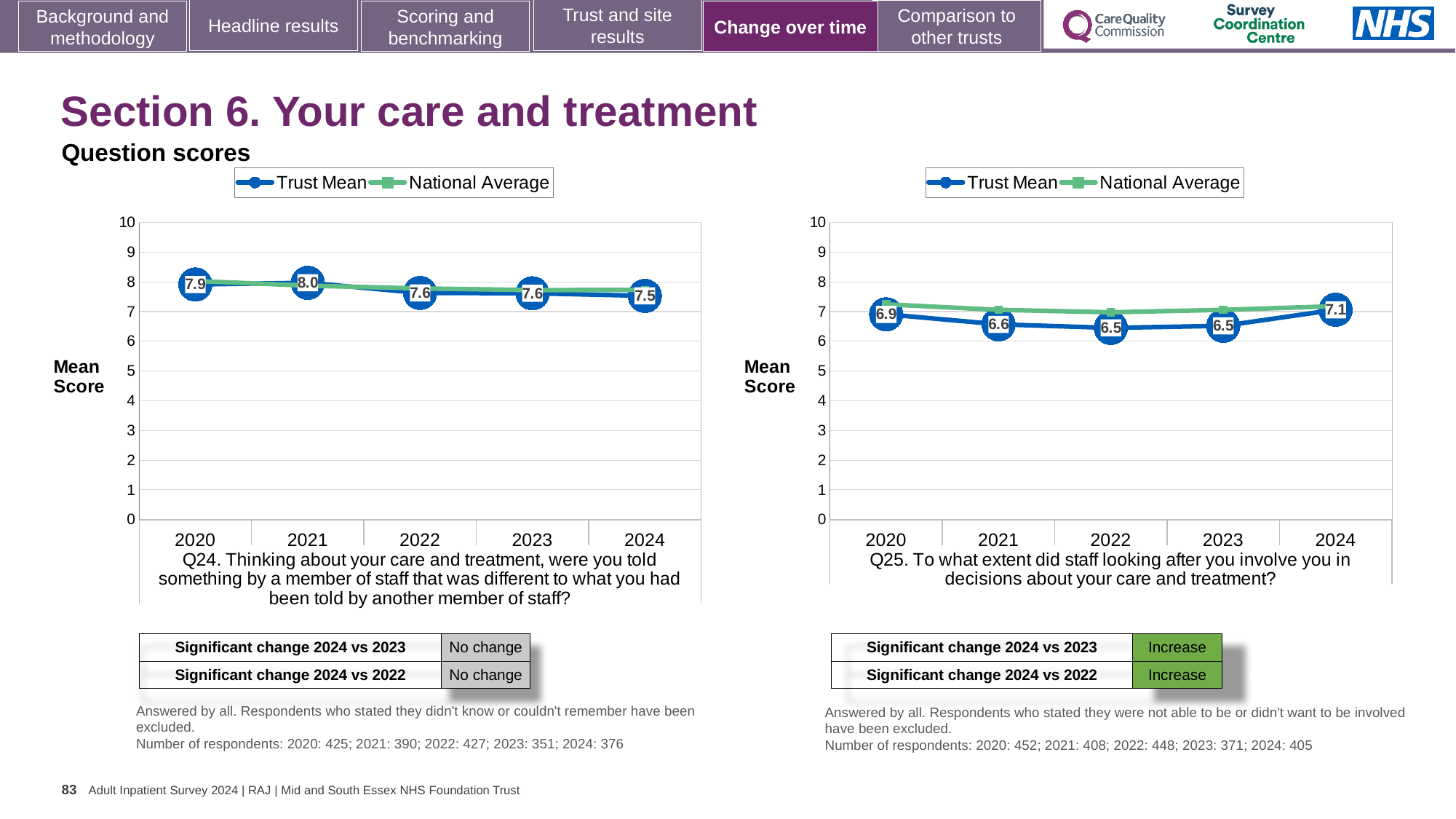
In the Q25 chart (right), is the Trust Mean score for 2020 greater or less than 5? greater What kind of chart is the Q24 chart (left)? Line chart In the Q25 chart (right), which year has the lowest Trust Mean score? 2022 and 2023 (tied at 6.5) In the Q24 chart (left), what is the difference between the Trust Mean scores for 2021 and 2024? 0.5 In the Q24 chart (left), what is the Trust Mean score for 2021? 8.0 In the Q25 chart (right), what is the difference between the Trust Mean scores for 2024 and 2020? 0.2 In the Q24 chart (left), which year has the highest Trust Mean score? 2021 How many years are shown on the x axis of the Q24 chart (left)? 5 In the Q24 chart (left), what is the Trust Mean score for 2024? 7.5 In the Q25 chart (right), what is the Trust Mean score for 2024? 7.1 How many series does the legend of the Q25 chart (right) list? 2 In the Q25 chart (right), what is the Trust Mean score for 2022? 6.5